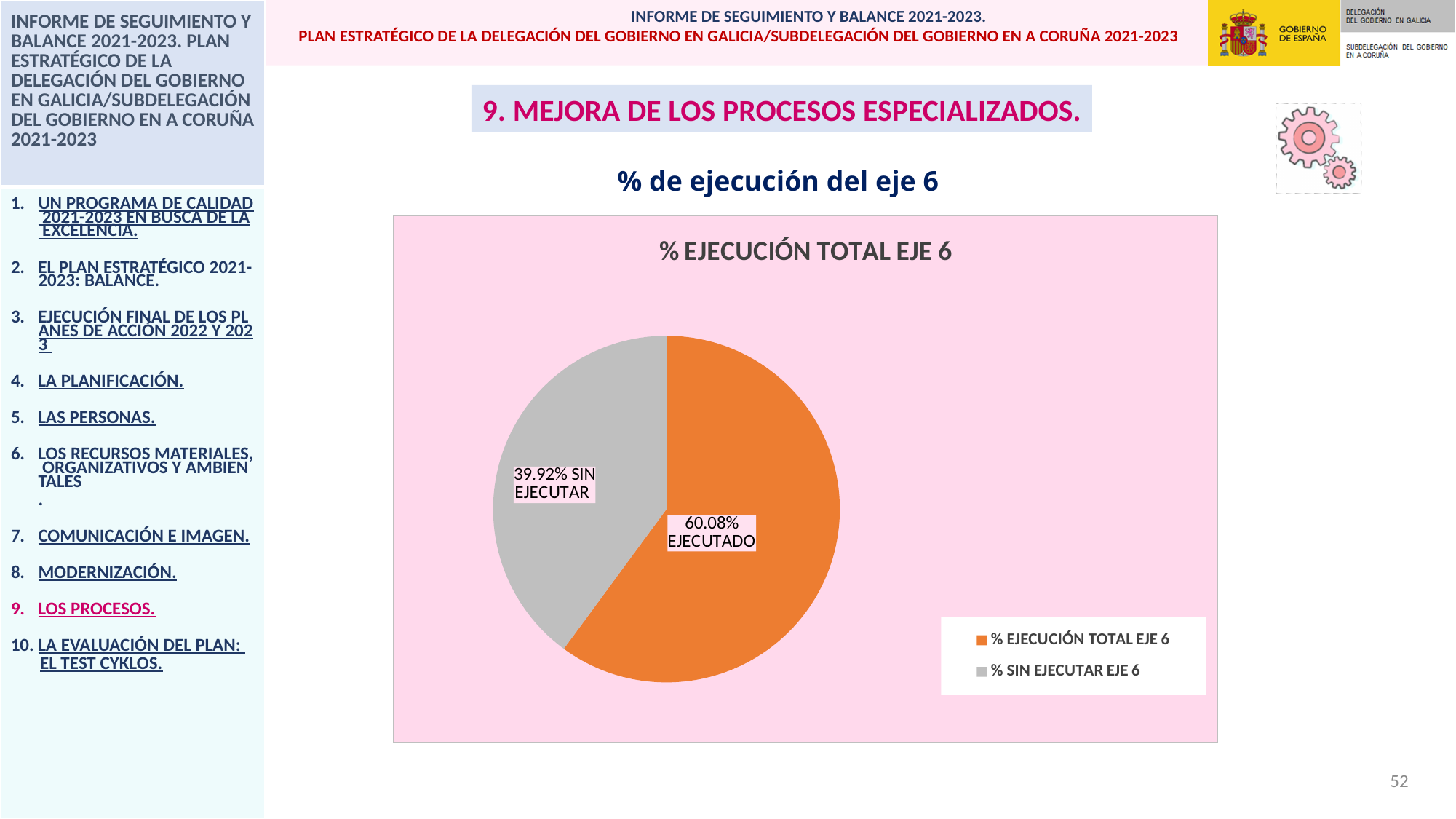
What percentage of eje 6 is shown as EJECUTADO? 60.08% What is the chart's title? % EJECUCIÓN TOTAL EJE 6 How many slices does the pie chart have? 2 What kind of chart is shown on the slide? pie chart Which is larger, the EJECUTADO share or the SIN EJECUTAR share? EJECUTADO What is the difference between the EJECUTADO share and the SIN EJECUTAR share? 20.16% Which slice is the smallest in the pie chart? % SIN EJECUTAR EJE 6 Which slice is the largest in the pie chart? % EJECUCIÓN TOTAL EJE 6 What colour is the % SIN EJECUTAR EJE 6 slice? grey What percentage of eje 6 is shown as SIN EJECUTAR? 39.92% How many entries does the legend list? 2 What is the total of the two slices shown in the pie chart? 100%